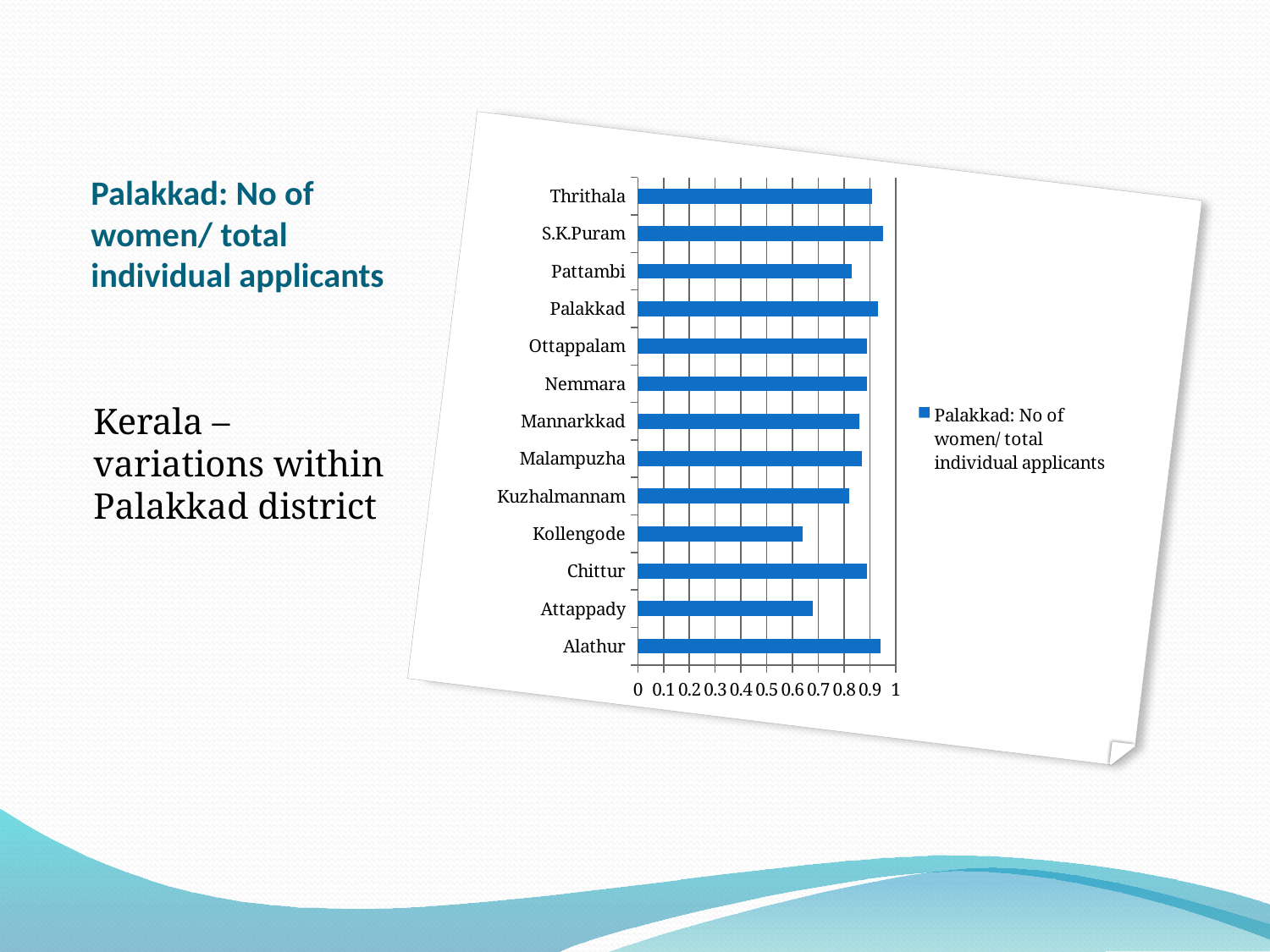
Is the value for Kollengode greater or less than 0.7? less Is the value for Kuzhalmannam greater or less than 0.7? greater Which area has the lowest value in the chart? Kollengode Which has the larger value, Kollengode or Chittur? Chittur Is the value for S.K.Puram greater or less than 0.9? greater Which has the larger value, Pattambi or S.K.Puram? S.K.Puram How many categories (areas) are plotted in the chart? 13 What is the legend entry for the series in the chart? Palakkad: No of women/ total individual applicants What kind of chart is shown on the slide? Bar chart Which has the larger value, Attappady or Alathur? Alathur How many series does the chart legend list? 1